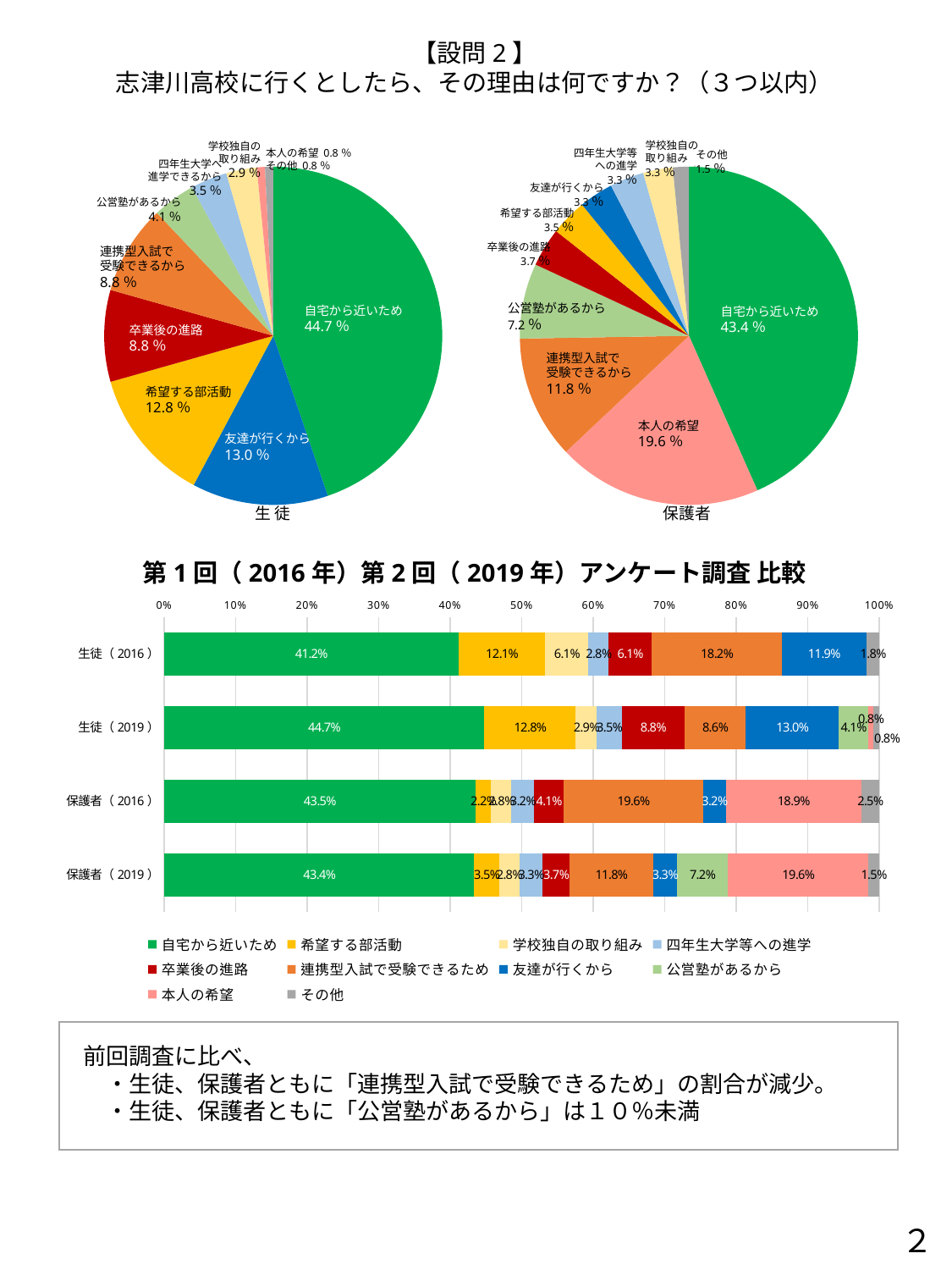
In the bar chart 第1回（2016年）第2回（2019年）アンケート調査 比較, what is the value of 連携型入試で受験できるため for 生徒（2016）? 18.2% In the bar chart 第1回（2016年）第2回（2019年）アンケート調査 比較, how many bars (categories) are shown? 4 In the 生徒 pie chart, what percentage is shown for 希望する部活動? 12.8 % In the 保護者 pie chart, what share of the pie does 公営塾があるから take? 7.2 % In the bar chart 第1回（2016年）第2回（2019年）アンケート調査 比較, by how many percentage points did 連携型入試で受験できるため for 生徒 fall from 2016 (18.2%) to 2019 (8.6%)? 9.6 percentage points In the 保護者 pie chart, which is larger: 本人の希望 or 連携型入試で受験できるから? 本人の希望 In the 保護者 pie chart, what percentage is shown for 本人の希望? 19.6 % What kind of chart is the 第1回（2016年）第2回（2019年）アンケート調査 比較 chart? Stacked bar chart In the 生徒 pie chart, what percentage is shown for 友達が行くから? 13.0 % In the bar chart 第1回（2016年）第2回（2019年）アンケート調査 比較, how many series does the legend list? 10 In the bar chart 第1回（2016年）第2回（2019年）アンケート調査 比較, what is the value of 自宅から近いため for 保護者（2016）? 43.5% In the 生徒 pie chart, which reason has the largest slice? 自宅から近いため